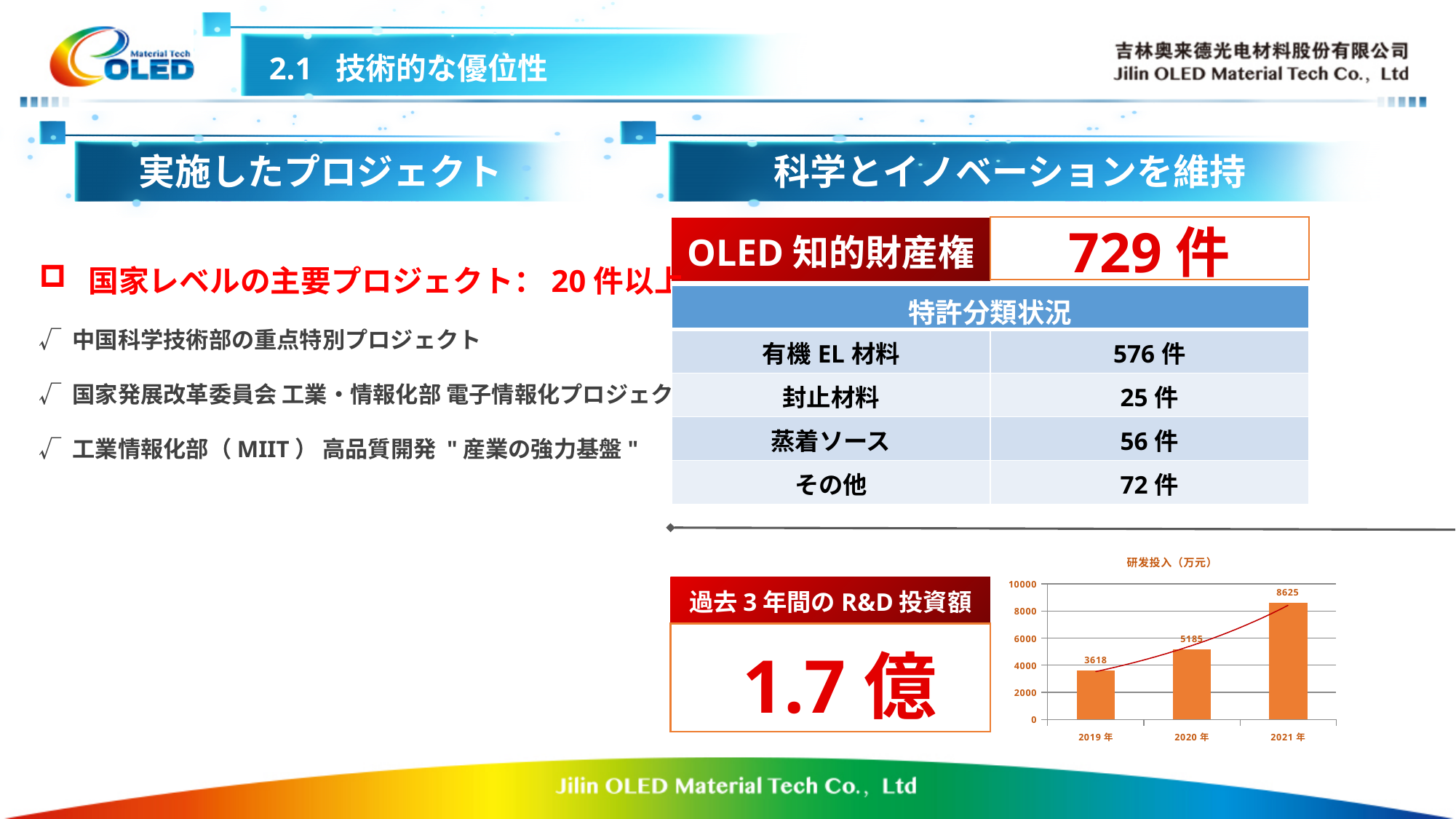
How many bars are plotted in the 研发投入 chart? 3 In the 研发投入 chart, what is the difference between the values for 2021年 and 2020年? 3440 In the 研发投入 chart, which year has the lowest value? 2019年 In the 研发投入 chart, do the values rise or fall from 2019年 to 2021年? rise In the 研发投入 chart, what is the value for 2019年? 3618 In the 研发投入 chart, what is the difference between the values for 2020年 and 2019年? 1567 In the 研发投入 chart, what is the value for 2021年? 8625 What is the title of the chart at the bottom right of the slide? 研发投入（万元） What type of chart is shown at the bottom right of the slide? bar chart In the 研发投入 chart, which year has the highest value? 2021年 In the 研发投入 chart, which is larger, the value for 2019年 or the value for 2020年? 2020年 In the 研发投入 chart, what is the value for 2020年? 5185